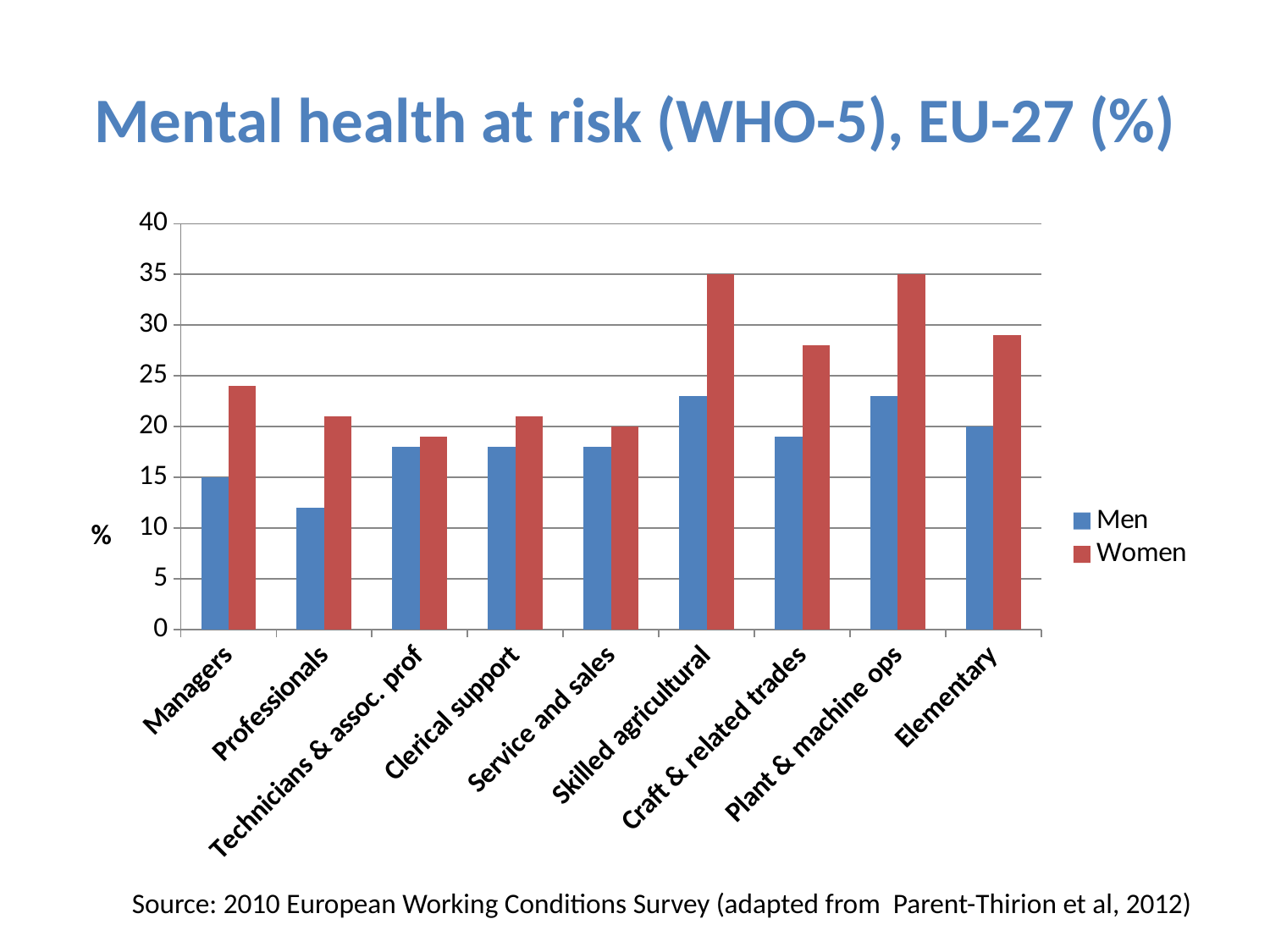
What is the title of the chart? Mental health at risk (WHO-5), EU-27 (%) What is the value for Men in the Managers category? 15 Is the value for Women in Craft & related trades greater or less than 25? greater Which colour represents the Women series in the legend? Red How many series does the legend list? 2 How many occupation categories are shown on the x axis? 9 Is the value for Men in Professionals greater or less than 15? less What is the value for Men in the Elementary category? 20 What kind of chart is shown on the slide? Bar chart Which category has the lowest value for Men? Professionals In the Plant & machine ops category, which is larger, the value for Men or for Women? Women What is the value for Women in the Skilled agricultural category? 35